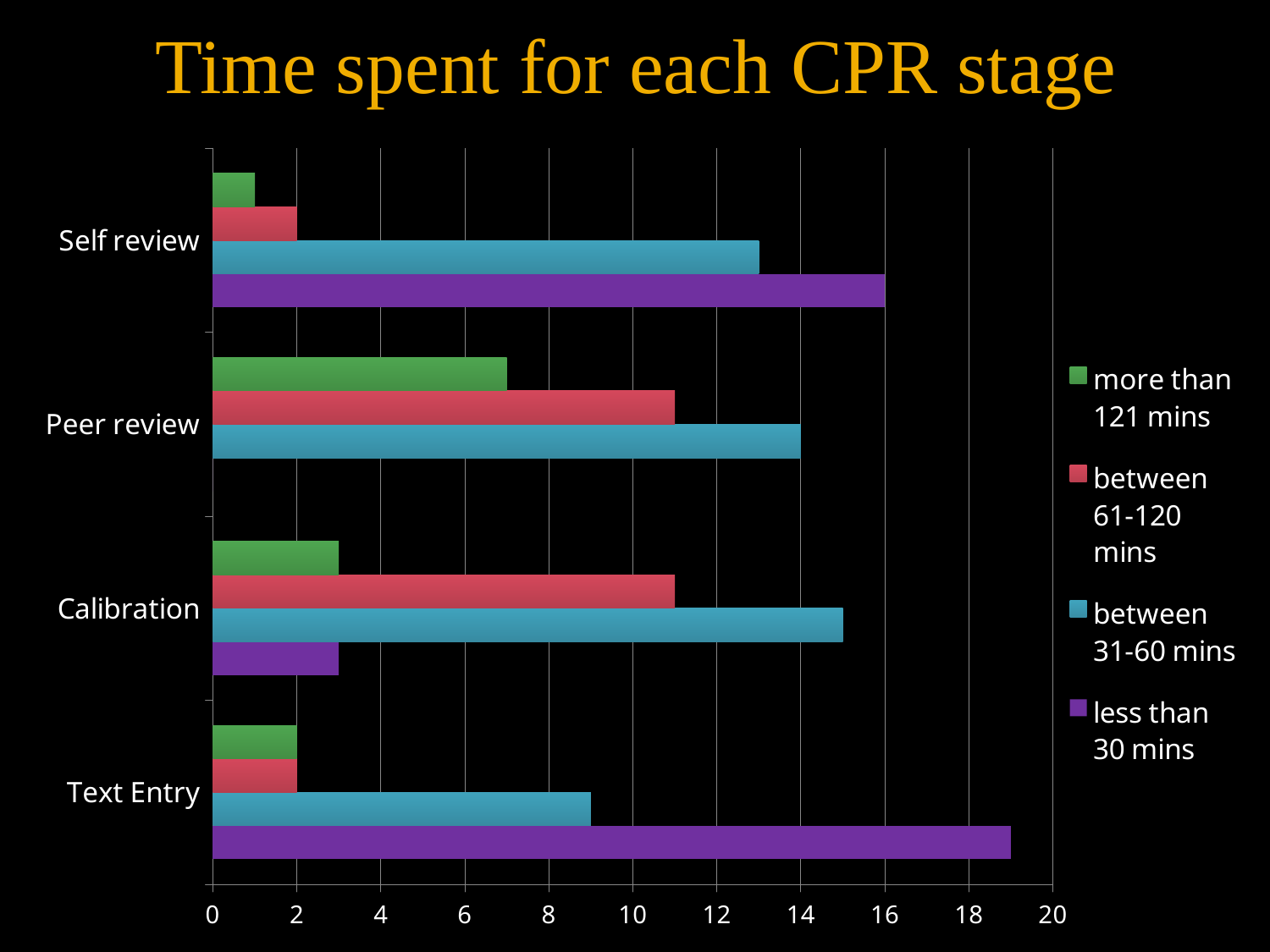
What is the value for 'less than 30 mins' in the Self review stage? 16 Which is larger: 'between 61-120 mins' for Peer review or 'between 31-60 mins' for Text Entry? between 61-120 mins for Peer review Within the Self review stage, which series has the smallest value? more than 121 mins Is the value for 'less than 30 mins' in the Text Entry stage greater or less than 18? greater What is the difference between the 'less than 30 mins' and 'between 61-120 mins' values for Self review? 14 What is the title of the chart? Time spent for each CPR stage What is the value for 'between 31-60 mins' in the Peer review stage? 14 What kind of chart is shown on the slide? bar chart How many series does the legend list? 4 Which stage and series has the longest bar on the chart? Text Entry, less than 30 mins What is the value for 'between 61-120 mins' in the Text Entry stage? 2 How many CPR stages (categories) are shown on the chart? 4